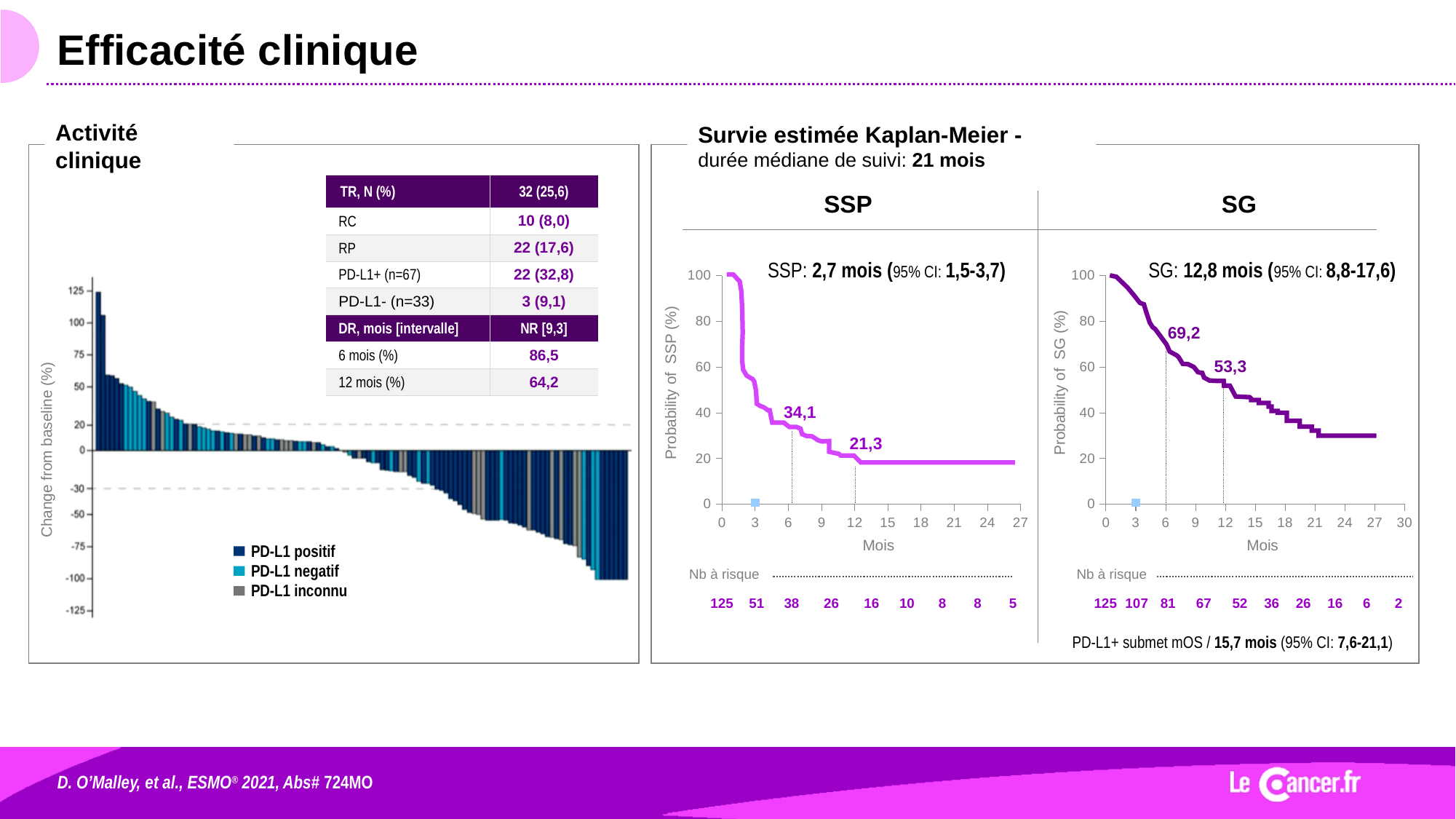
On the SSP chart, how many patients are at risk at 3 months? 51 On the SG chart, what is the difference between the labelled probabilities at 6 months and at 12 months? 15,9 How many entries does the legend of the 'Activité clinique' chart list? 3 On the SSP chart, does the curve rise or fall as months increase? fall At 12 months, which is larger: the labelled probability on the SG chart or on the SSP chart? SG On the SSP chart, what is the labelled probability of SSP at 12 months? 21,3 On the SG chart, is the probability of SG at 24 months greater or less than 20? greater On the SG chart, how many patients are at risk at 3 months? 107 On the SSP chart, what is the difference between the labelled probabilities at 6 months and at 12 months? 12,8 On the SSP chart, what is the labelled probability of SSP at 6 months? 34,1 On the SG chart, what is the labelled probability of SG at 6 months? 69,2 On the SG chart, what is the labelled probability of SG at 12 months? 53,3